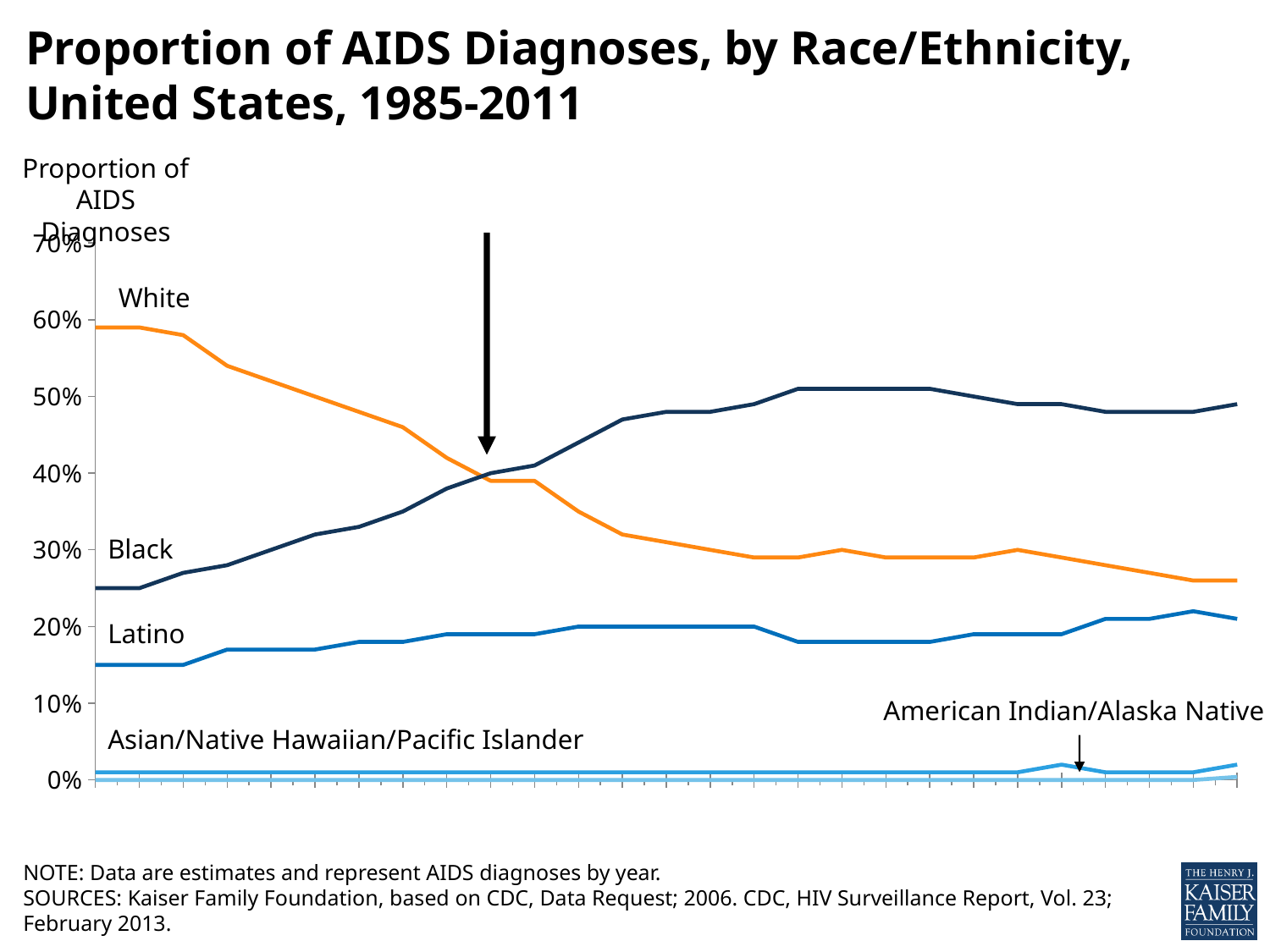
Does the proportion for Black rise or fall over the period shown? rise Which series has the highest proportion at the start of the period (leftmost point, 1985)? White Does the proportion for White rise or fall over the period shown? fall Is the proportion for Black at the end of the period (2011) greater or less than 40%? greater Is the proportion for White at the end of the period (2011) greater or less than 30%? less What kind of chart is shown on the slide? line chart What colour is the line for White? orange Is the proportion for Black at the start of the period (1985) greater or less than 30%? less Which series has the highest proportion at the end of the period (rightmost point, 2011)? Black At the end of the period (2011), which is larger: the proportion for White or for Latino? White How many race/ethnicity series are plotted on the chart? 5